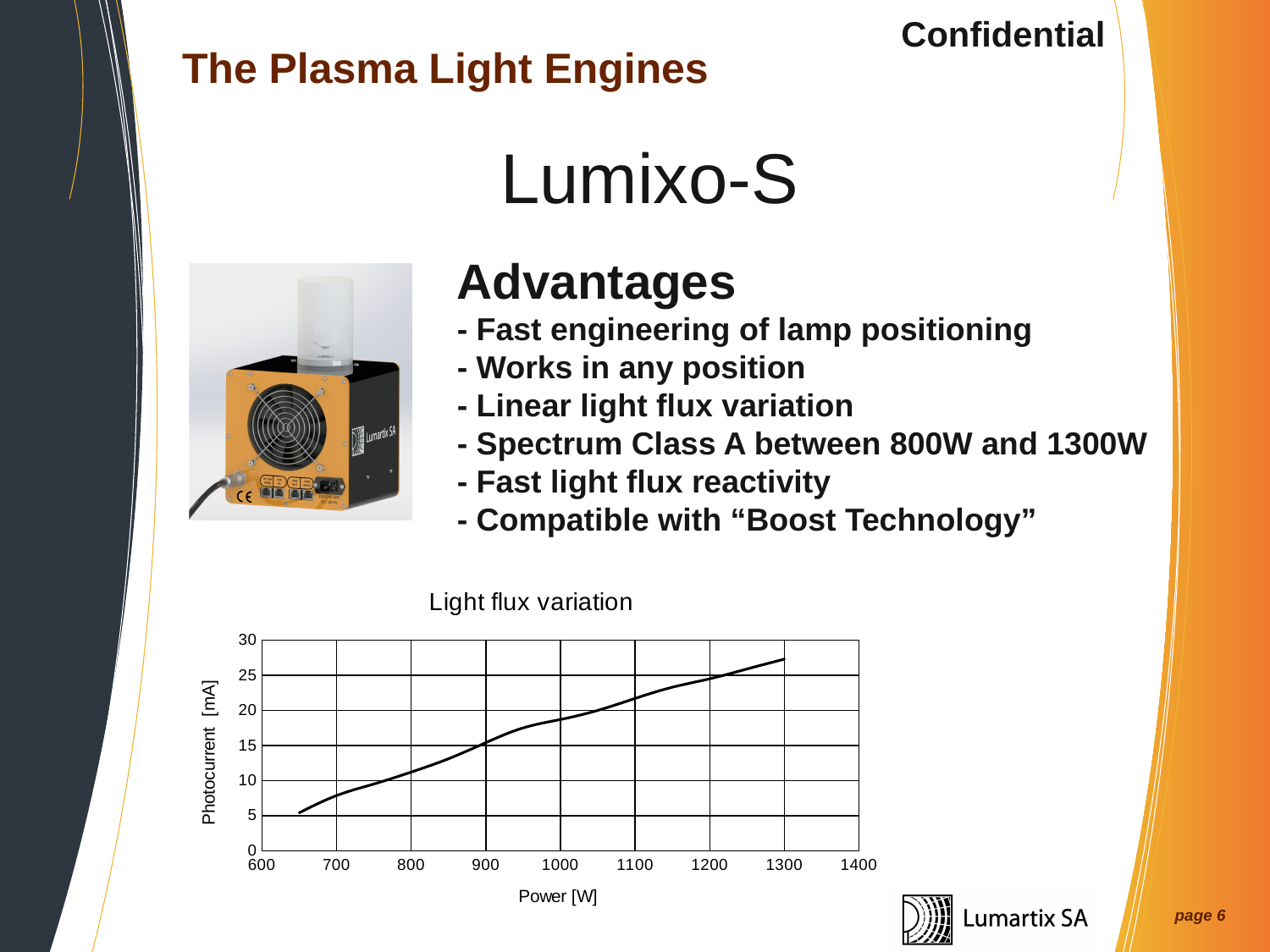
In the "Light flux variation" chart, is the photocurrent at 700 W greater or less than 10 mA? less In the "Light flux variation" chart, does the photocurrent rise or fall as power increases? rise What is the title of the chart on the slide? Light flux variation In the "Light flux variation" chart, is the photocurrent at 1300 W greater or less than 25 mA? greater What is the label of the x axis of the "Light flux variation" chart? Power [W] In the "Light flux variation" chart, is the photocurrent at 1300 W greater or less than 30 mA? less What kind of chart is the "Light flux variation" chart? line chart In the "Light flux variation" chart, is the photocurrent higher at 1200 W or at 900 W? 1200 W